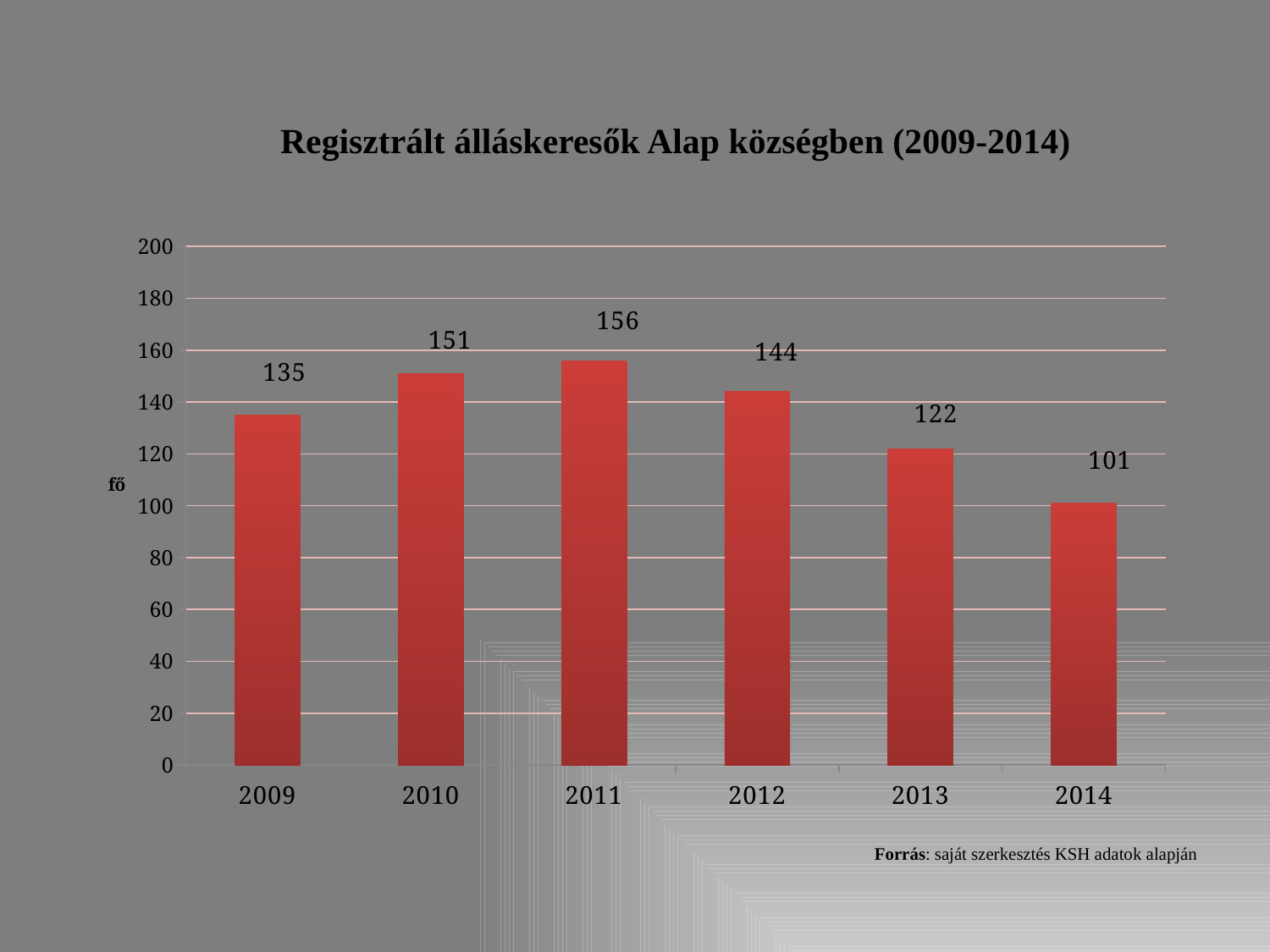
Is the value for 2013 greater or less than 140? less What is the value for 2009? 135 What is the title of the chart? Regisztrált álláskeresők Alap községben (2009-2014) Which year has the lowest value? 2014 Which is larger, the value for 2009 or the value for 2012? 2012 Which year has the highest value? 2011 What kind of chart is this? bar chart What is the value for 2012? 144 What is the difference between the values for 2010 and 2013? 29 How many years are shown on the x axis? 6 What is the difference between the values for 2011 and 2014? 55 What is the value for 2014? 101